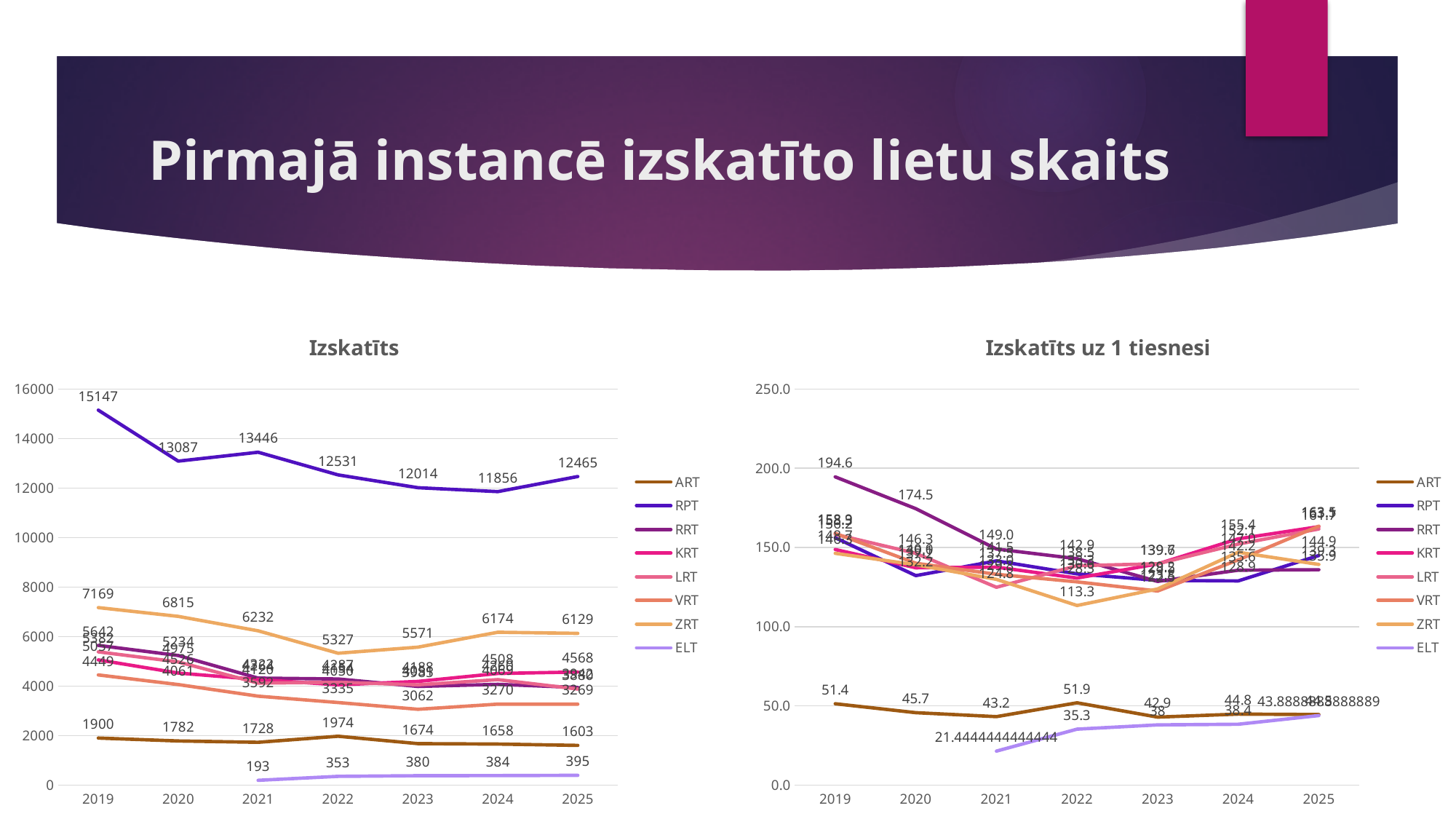
In the 'Izskatīts' chart, which is larger: ZRT in 2024 or ZRT in 2025? 2024 In the 'Izskatīts uz 1 tiesnesi' chart, what is the value for RRT in 2019? 194.6 In the 'Izskatīts' chart, what is the value for ART in 2022? 1974 How many series does the legend of the 'Izskatīts' chart list? 8 In the 'Izskatīts' chart, what is the value for ELT in 2021? 193 In the 'Izskatīts' chart, what is the difference between the RPT values in 2019 and 2025? 2682 In the 'Izskatīts uz 1 tiesnesi' chart, what is the value for ART in 2022? 51.9 In the 'Izskatīts' chart, in which year is the RPT value lowest? 2024 In the 'Izskatīts' chart, what is the value for ZRT in 2019? 7169 What kind of chart is the 'Izskatīts' chart on the left? line chart How many years are shown on the x axis of the 'Izskatīts uz 1 tiesnesi' chart? 7 In the 'Izskatīts' chart, what is the value for RPT in 2019? 15147